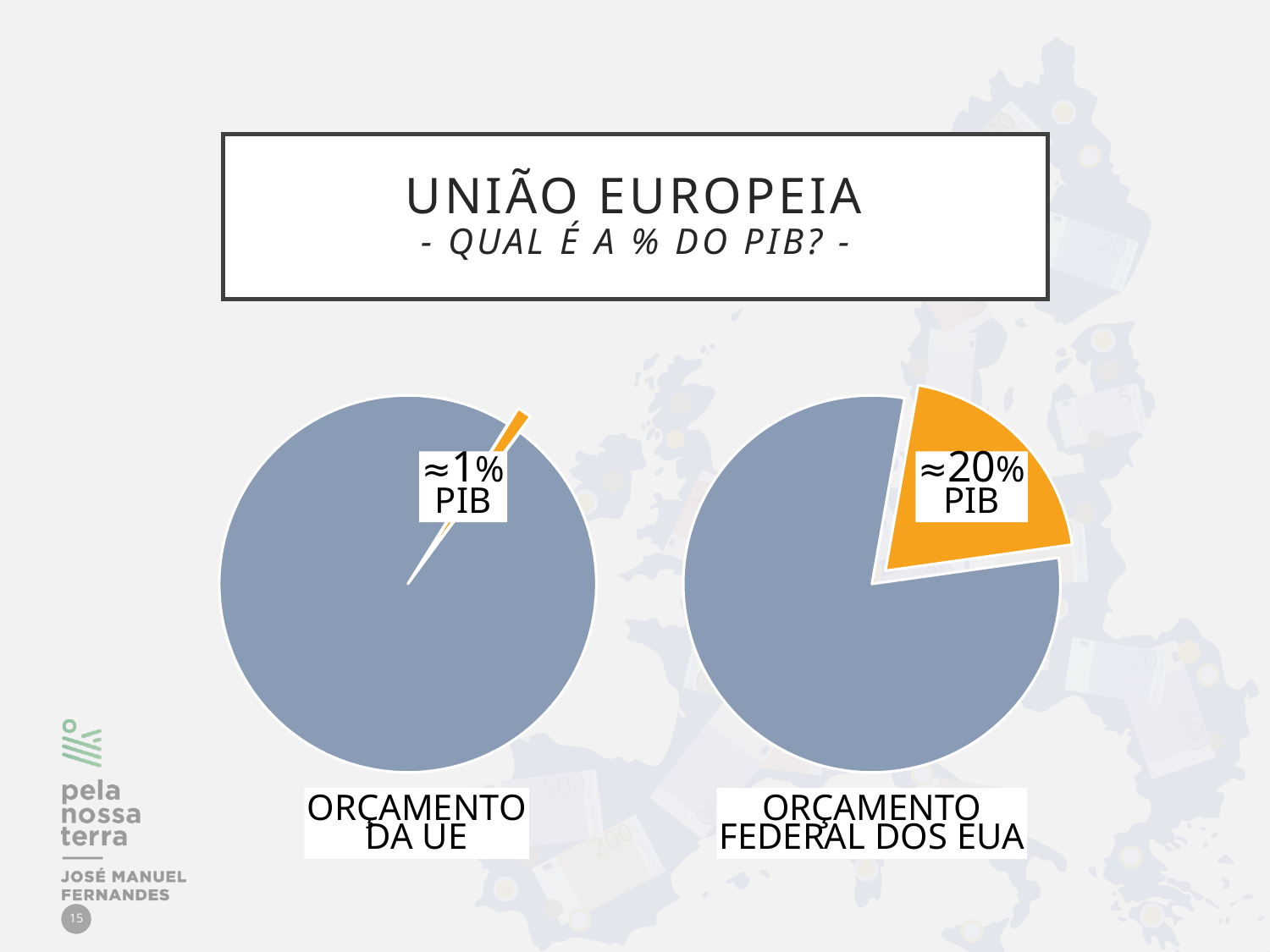
What kind of chart is used for ORÇAMENTO DA UE? pie chart Which pie chart shows the smaller highlighted share of PIB, ORÇAMENTO DA UE or ORÇAMENTO FEDERAL DOS EUA? ORÇAMENTO DA UE Which pie chart shows the larger highlighted share of PIB, ORÇAMENTO DA UE or ORÇAMENTO FEDERAL DOS EUA? ORÇAMENTO FEDERAL DOS EUA In the ORÇAMENTO DA UE pie chart, what share of PIB is labelled on the highlighted slice? ≈1% What kind of chart is used for ORÇAMENTO FEDERAL DOS EUA? pie chart How many pie charts are shown on the slide? 2 What colour is the highlighted PIB slice in both pie charts? orange How many slices does the ORÇAMENTO DA UE pie chart have? 2 What is the title of the slide containing the two pie charts? UNIÃO EUROPEIA - QUAL É A % DO PIB? - Which pie chart is on the left of the slide? ORÇAMENTO DA UE In the ORÇAMENTO FEDERAL DOS EUA pie chart, what share of PIB is labelled on the highlighted slice? ≈20% How many slices does the ORÇAMENTO FEDERAL DOS EUA pie chart have? 2